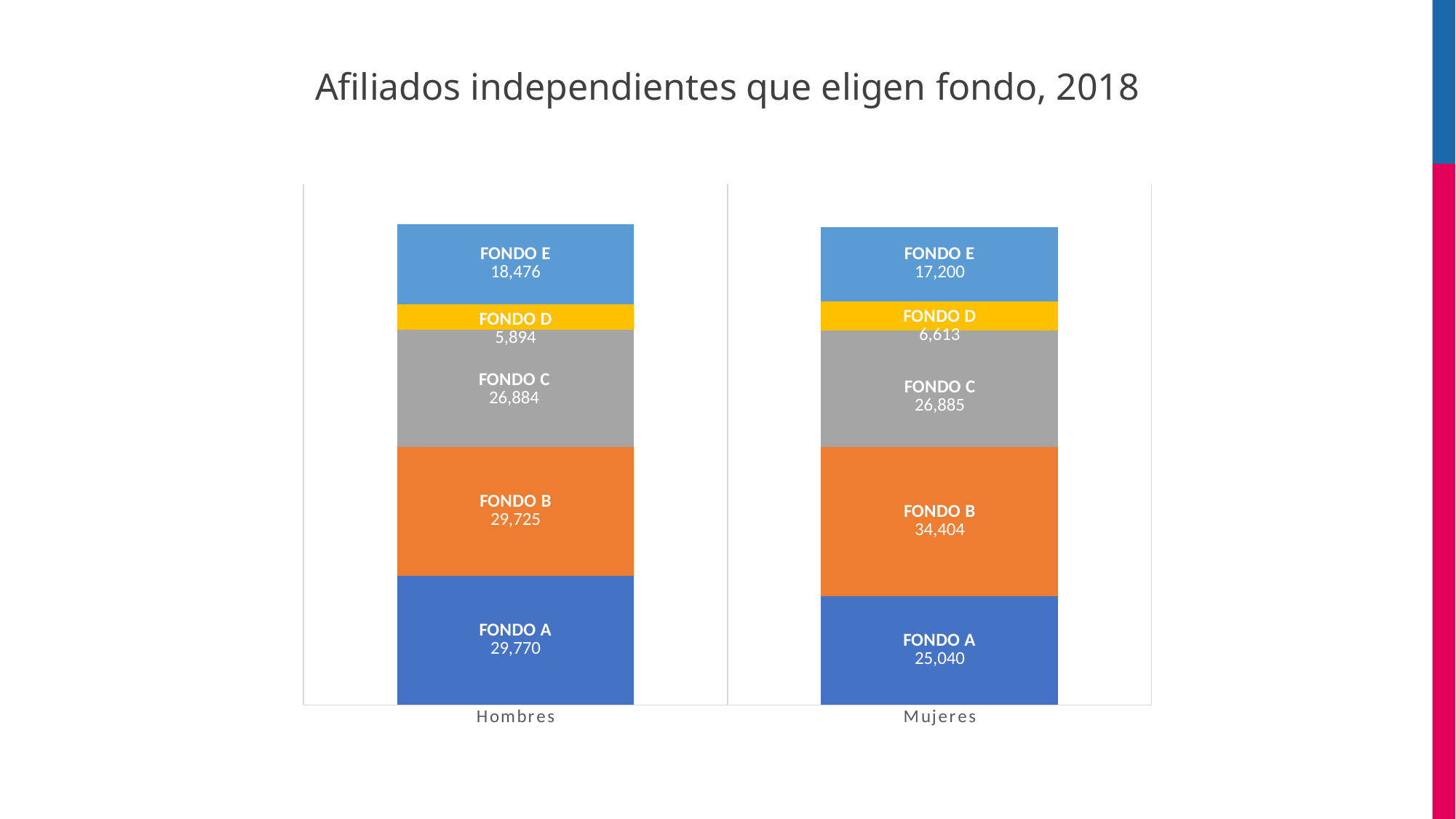
What is the difference between the Fondo B values for Mujeres and Hombres? 4,679 What is the total of the Hombres stacked bar? 110,749 What is the value of Fondo B for Mujeres? 34,404 What is the value of Fondo A for Hombres? 29,770 What is the difference between the Fondo A values for Hombres and Mujeres? 4,730 What is the value of Fondo D for Hombres? 5,894 How many categories are shown on the x axis? 2 Which fondo has the largest value in the Mujeres bar? Fondo B Which is larger, the Fondo E value for Hombres or for Mujeres? Hombres What type of chart is shown on the slide? Stacked bar chart What is the value of Fondo E for Mujeres? 17,200 Which fondo has the smallest value in the Hombres bar? Fondo D